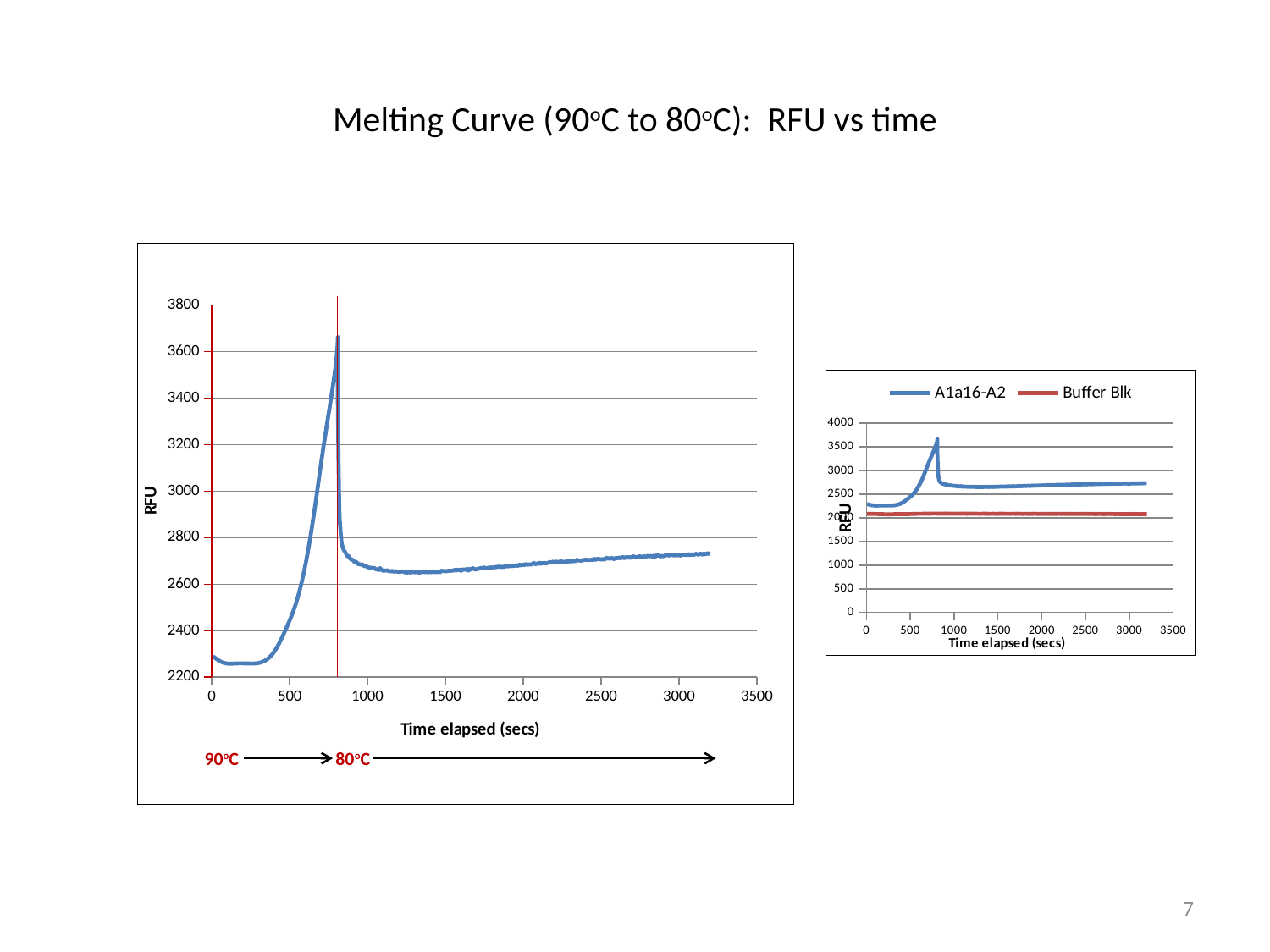
In the smaller chart on the right, is the peak value of A1a16-A2 greater or less than 3000? greater In the smaller chart on the right, what are the two series named in the legend? A1a16-A2 and Buffer Blk In the large chart on the left, does the RFU value rise or fall between 0 and about 800 seconds? rise In the smaller chart on the right, which series has the larger value at 3000 seconds, A1a16-A2 or Buffer Blk? A1a16-A2 What kind of chart is the large chart on the left of the slide? line chart In the large chart on the left, what is the title of the x axis? Time elapsed (secs) In the large chart on the left, is the RFU value at time 0 greater or less than 2400? less How many series does the legend of the smaller chart on the right list? 2 In the large chart on the left, is the RFU value at 3000 seconds greater or less than 2800? less In the smaller chart on the right, which series has the lower values throughout? Buffer Blk